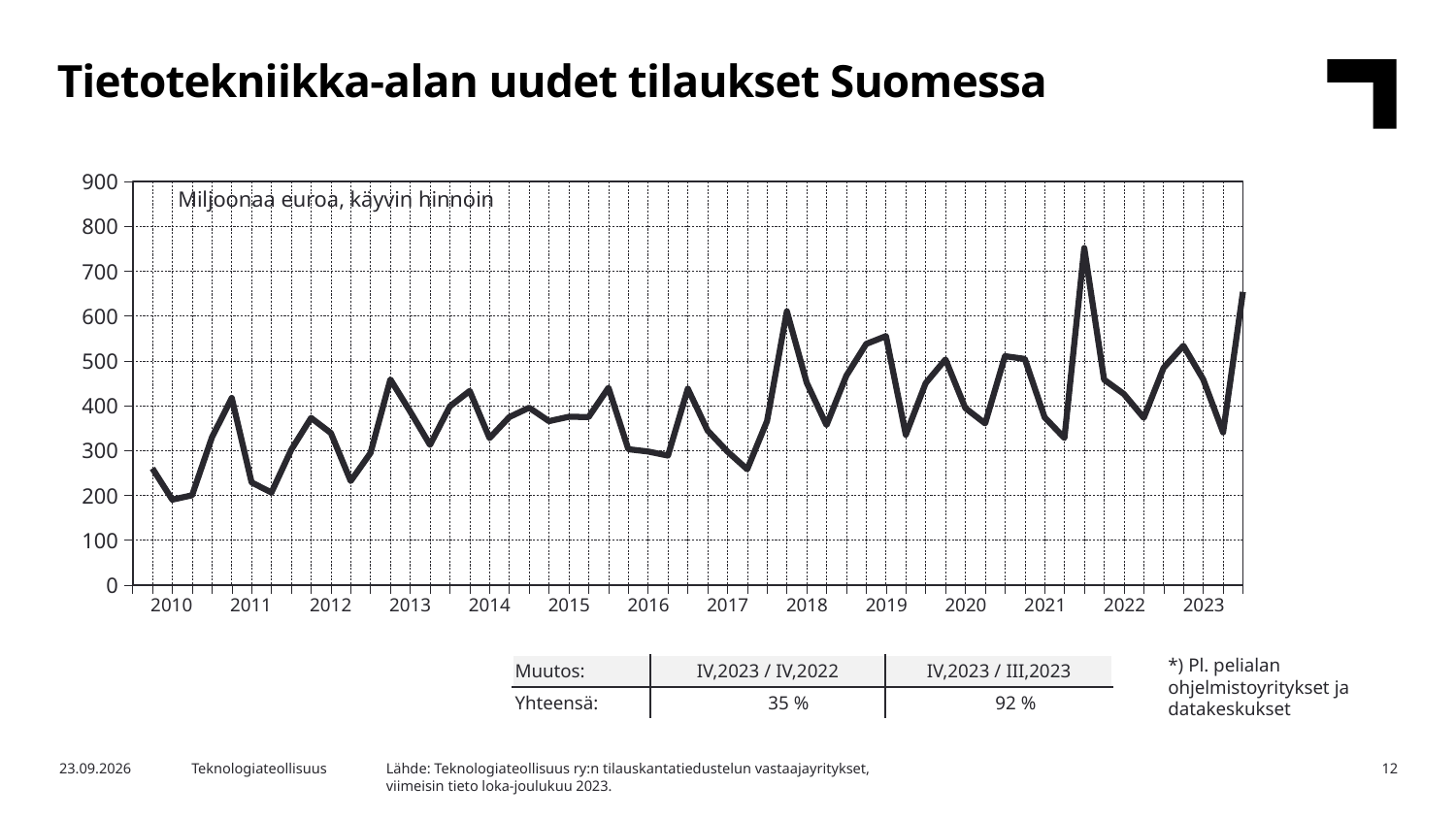
Is the last value on the line, at the end of 2023, greater or less than 600? greater Which is larger: the peak value in 2021 or the peak value in 2018? 2021 What kind of chart is shown on the slide? line chart Is the first value on the line, at the start of 2010, greater or less than 300? less In what unit are the values on the chart expressed, according to the label inside the plot area? Miljoonaa euroa, käyvin hinnoin Is the lowest value of the line in 2017 greater or less than 300? less What is the highest value shown on the y axis of the chart? 900 How many years are labelled on the x axis of the chart? 14 What is the title of the chart on the slide? Tietotekniikka-alan uudet tilaukset Suomessa In which year does the line reach its highest peak? 2021